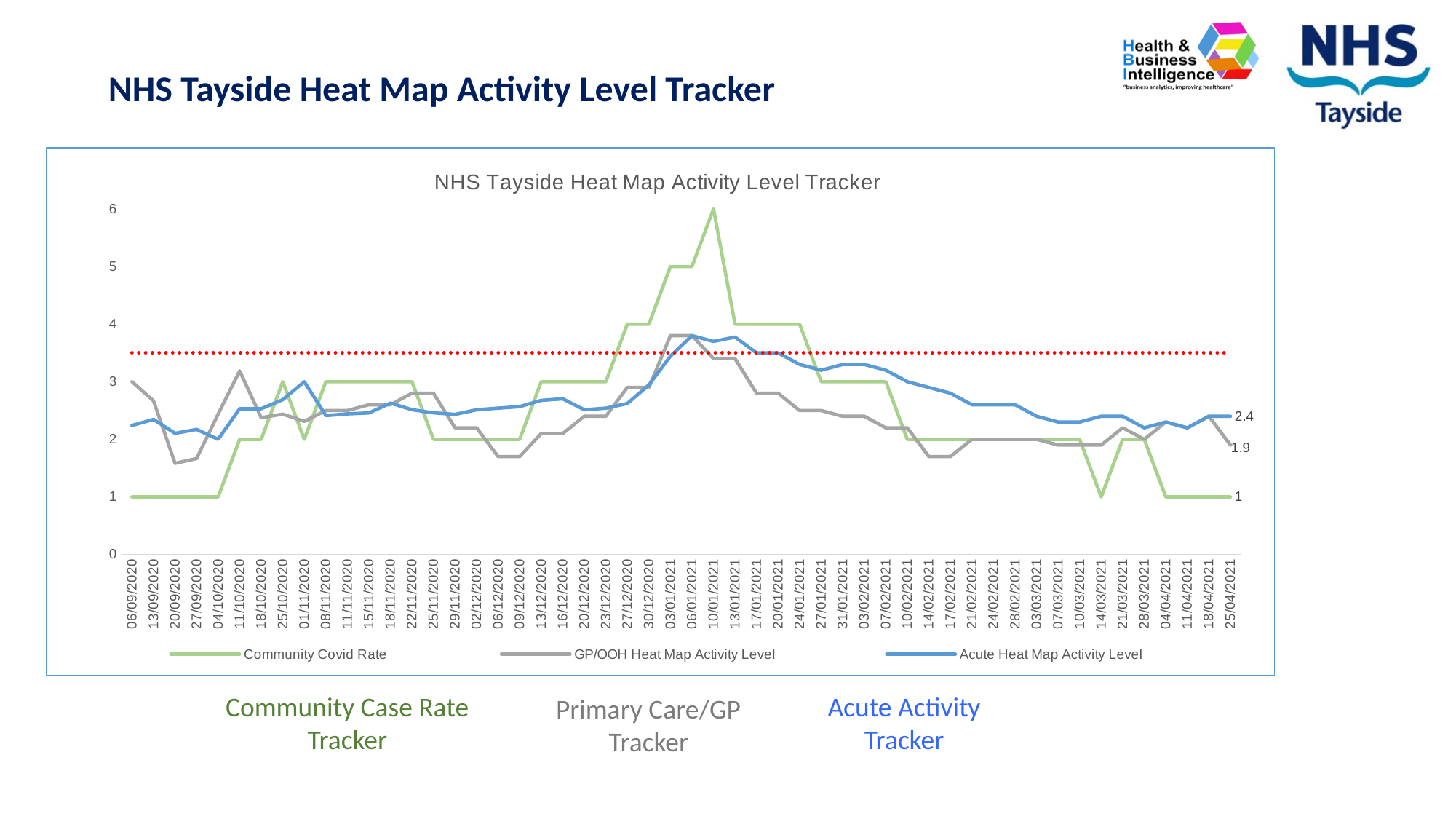
On 25/04/2021, which is larger: the Acute Heat Map Activity Level or the GP/OOH Heat Map Activity Level? Acute Heat Map Activity Level What is the value of the Acute Heat Map Activity Level on 25/04/2021? 2.4 Does the Community Covid Rate rise or fall between 10/01/2021 and 25/04/2021? fall What is the value of the GP/OOH Heat Map Activity Level on 25/04/2021? 1.9 What kind of chart is shown on the slide? line chart On which date does the Community Covid Rate reach its highest value? 10/01/2021 What is the title of the chart? NHS Tayside Heat Map Activity Level Tracker Is the value for the Community Covid Rate on 06/09/2020 greater or less than 2? less How many series does the legend list? 3 What is the difference between the Acute Heat Map Activity Level and the GP/OOH Heat Map Activity Level on 25/04/2021? 0.5 Is the value for the Acute Heat Map Activity Level on 06/01/2021 greater or less than 3? greater What is the value of the Community Covid Rate on 25/04/2021? 1